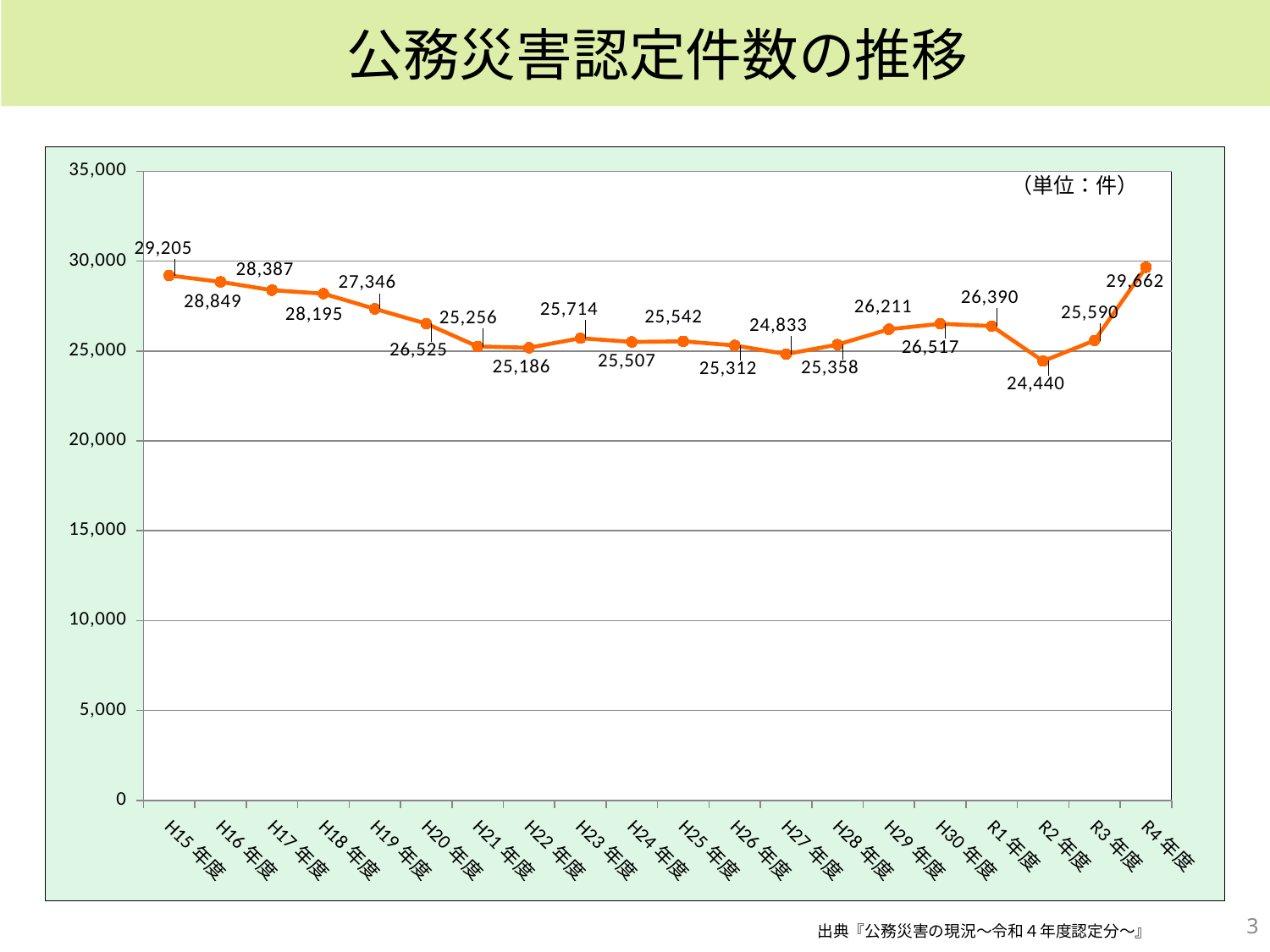
What is the value for R2年度? 24,440 Which fiscal year has the highest value? R4年度 What is the difference between the values for R3年度 and R2年度? 1,150 Which fiscal year has the lowest value? R2年度 How many fiscal years are plotted on the x axis? 20 What is the value for H15年度? 29,205 What type of chart is shown on the slide? line chart What is the value for H30年度? 26,517 Do the values rise or fall from H15年度 to H22年度? fall Which is larger, the value for H20年度 or the value for H29年度? H20年度 What is the value for H27年度? 24,833 What is the difference between the values for R4年度 and H15年度? 457